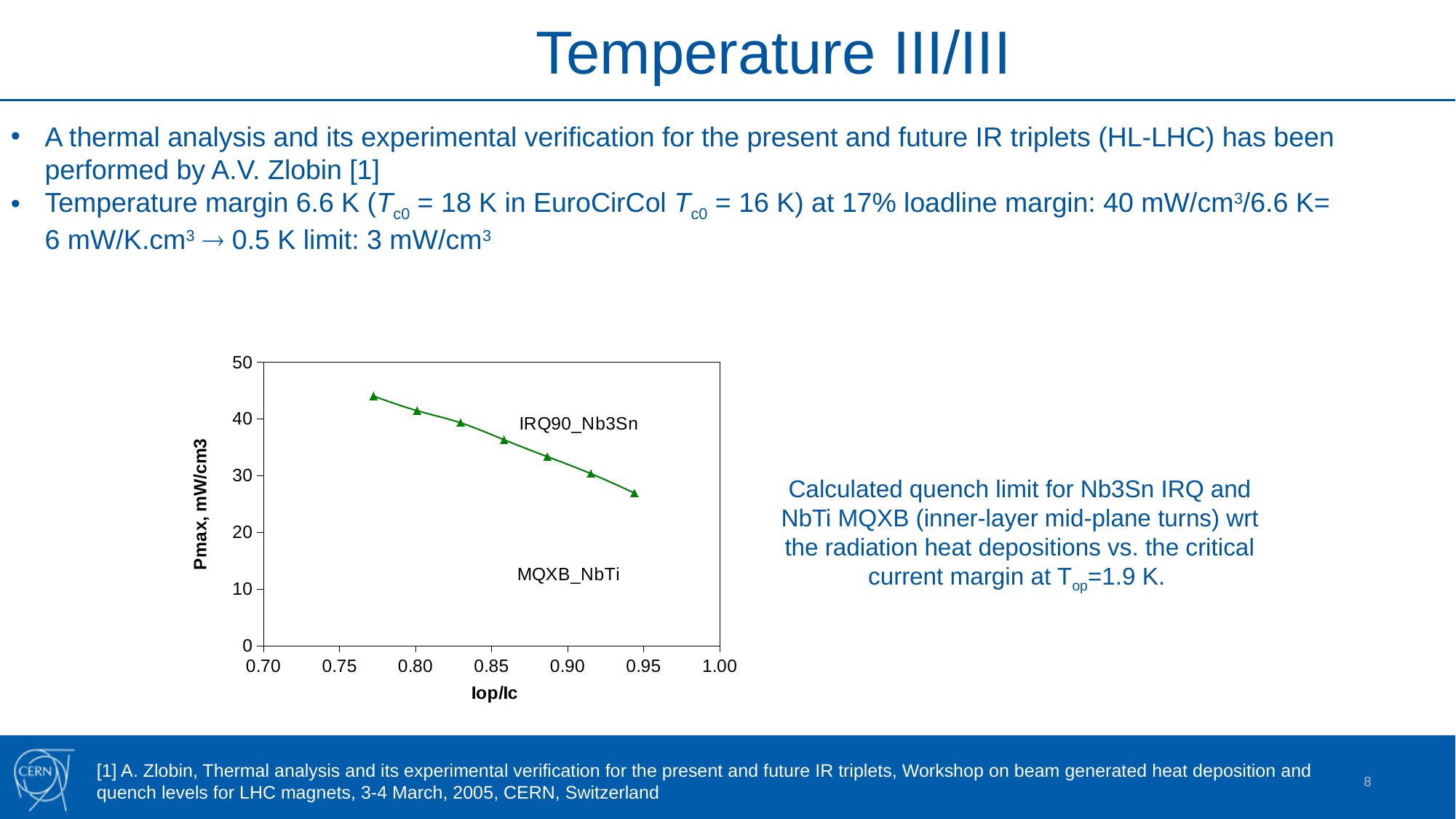
What is the title of the y axis of the chart? Pmax, mW/cm3 Which point on the IRQ90_Nb3Sn curve has the highest Pmax, the leftmost or the rightmost? leftmost Is the Pmax value of the leftmost point on the IRQ90_Nb3Sn curve greater or less than 50? less How many data points are marked on the IRQ90_Nb3Sn curve? 7 What kind of chart is shown on the slide? line chart Is the Pmax value of the leftmost point on the IRQ90_Nb3Sn curve greater or less than 40? greater Is the Pmax value of the rightmost point on the IRQ90_Nb3Sn curve greater or less than 30? less Does the IRQ90_Nb3Sn curve rise or fall as Iop/Ic increases? fall What is the title of the x axis of the chart? Iop/Ic